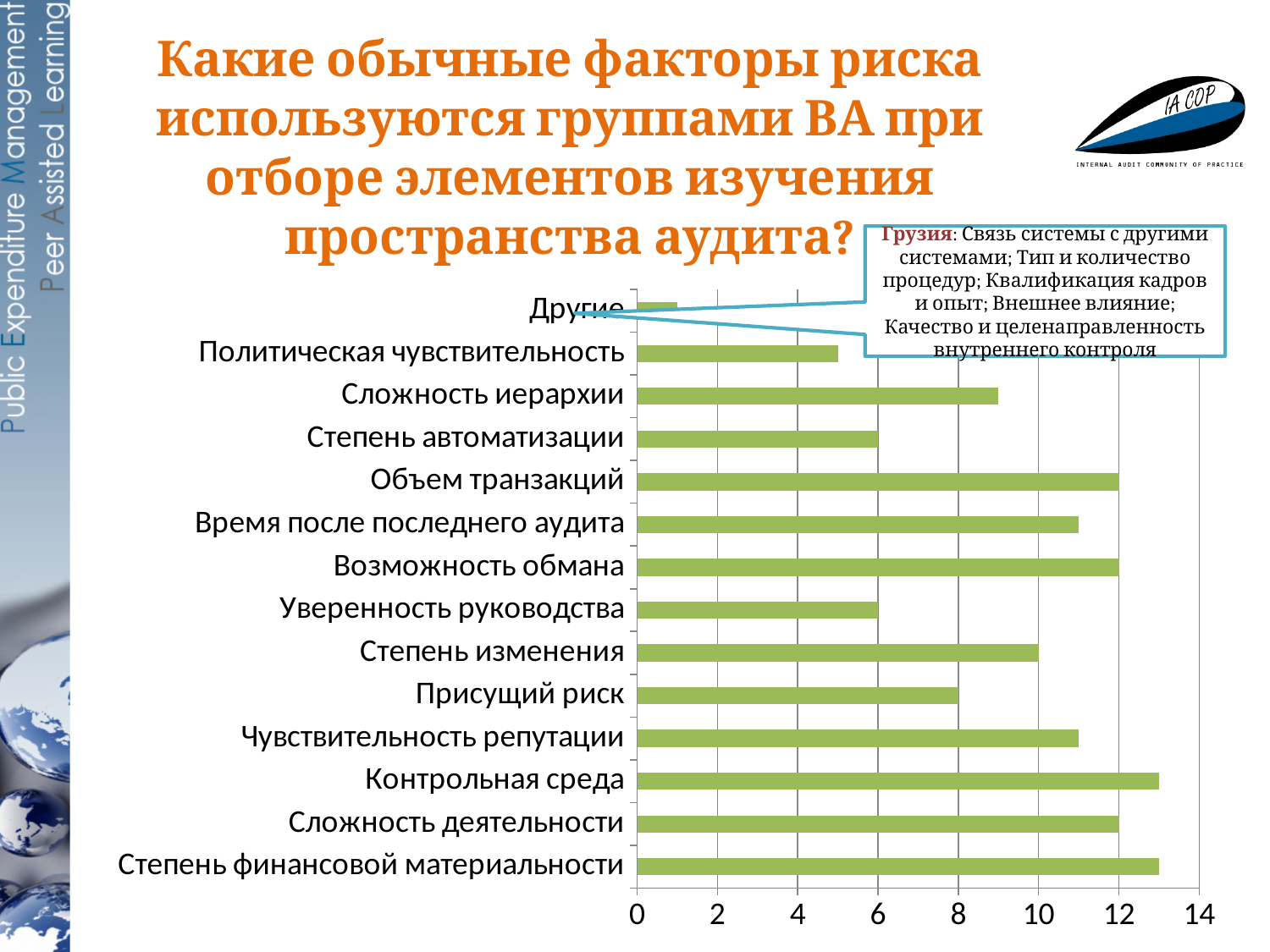
What is the value for Присущий риск? 8 What is the difference between the values for Объем транзакций and Степень автоматизации? 6 What is the value for Степень автоматизации? 6 What kind of chart is shown on the slide? bar chart Is the value for Политическая чувствительность greater or less than 6? less Which category has the lowest value in the chart? Другие What is the value for Объем транзакций? 12 Which is larger, the value for Контрольная среда or the value for Присущий риск? Контрольная среда What is the highest value shown on the horizontal axis of the chart? 14 Is the value for Контрольная среда greater or less than 12? greater What is the value for Степень изменения? 10 How many categories (risk factors) are plotted in the chart? 14